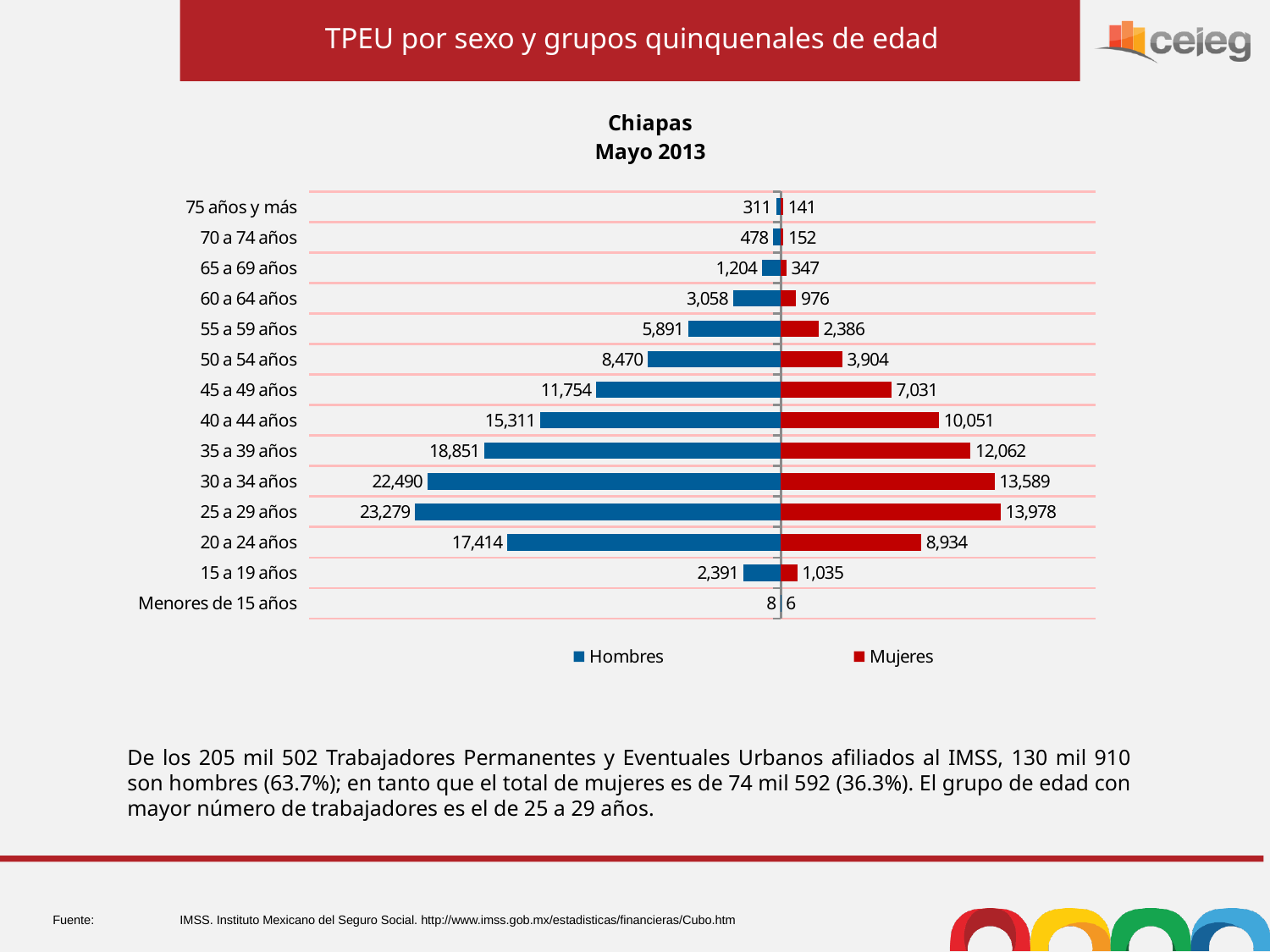
Which is larger: Hombres in the 20 a 24 años group or Hombres in the 35 a 39 años group? 35 a 39 años Which age group has the highest value for Mujeres? 25 a 29 años What is the value for Hombres in the 25 a 29 años age group? 23,279 How many series does the legend list? 2 How many age groups are shown on the chart? 14 Which age group has the lowest value for Hombres? Menores de 15 años What is the total of Hombres and Mujeres in the 45 a 49 años age group? 18,785 What is the value for Mujeres in the 40 a 44 años age group? 10,051 What kind of chart is shown on the slide? Bar chart What is the value for Hombres in the 60 a 64 años age group? 3,058 What is the difference between Hombres and Mujeres in the 30 a 34 años age group? 8,901 Which colour represents Mujeres in the chart? Red